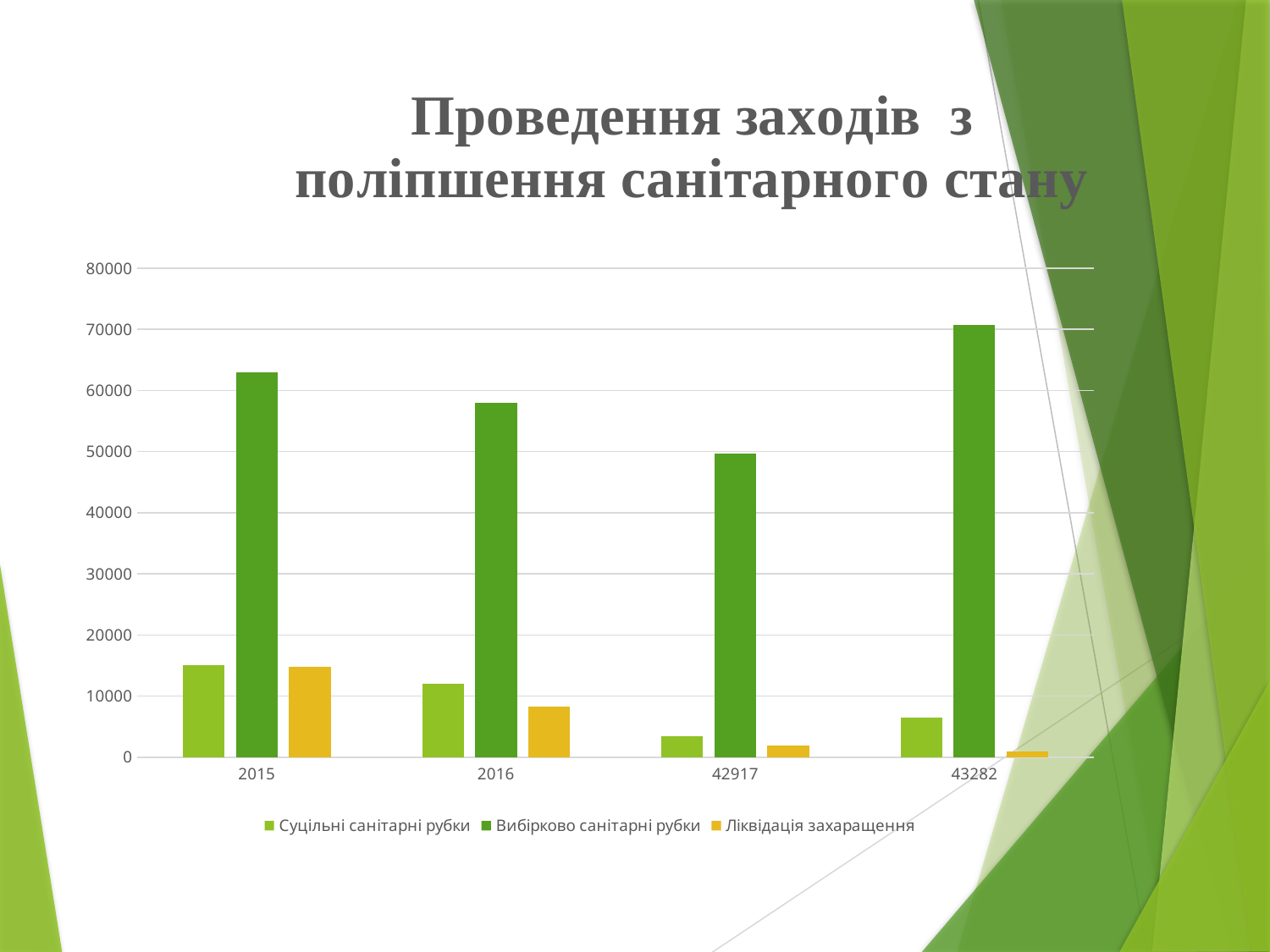
How many categories are shown on the x axis? 4 How many series does the legend list? 3 What is the title of the chart? Проведення заходів з поліпшення санітарного стану For which category is the value of Вибірково санітарні рубки lowest? 42917 What kind of chart is shown on the slide? bar chart For which category is the value of Вибірково санітарні рубки highest? 43282 Which series is shown in yellow in the legend? Ліквідація захаращення Do the values of Ліквідація захаращення rise or fall across the categories from 2015 to 43282? fall For which category is the value of Ліквідація захаращення highest? 2015 Which is larger for 2016: Суцільні санітарні рубки or Ліквідація захаращення? Суцільні санітарні рубки